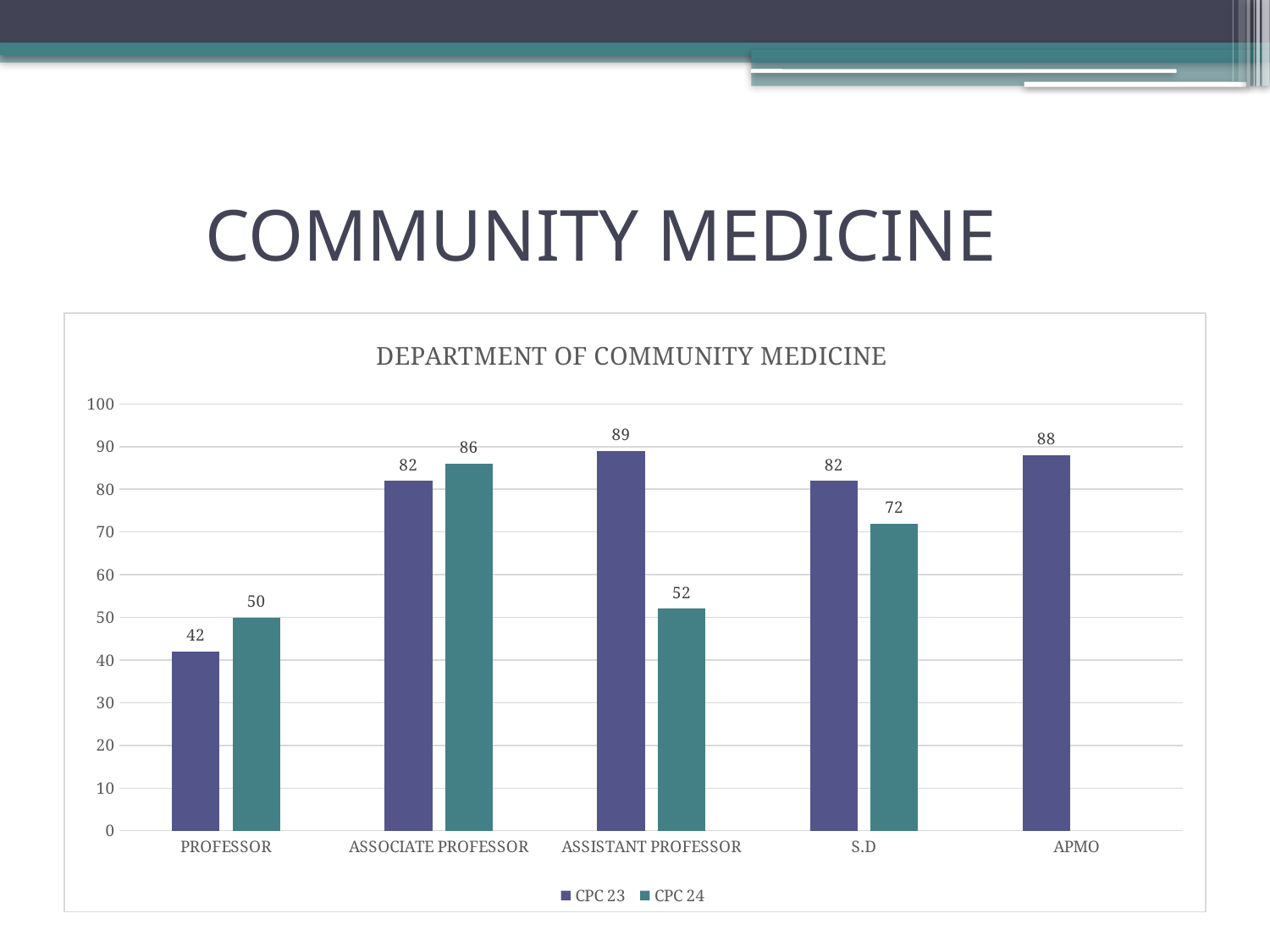
What is the difference between the CPC 23 and CPC 24 values for ASSISTANT PROFESSOR? 37 What is the title of the chart? DEPARTMENT OF COMMUNITY MEDICINE How many series does the legend list? 2 What is the CPC 24 value for ASSISTANT PROFESSOR? 52 What is the CPC 23 value for PROFESSOR? 42 What is the CPC 24 value for S.D? 72 How many categories are shown on the x axis? 5 For ASSOCIATE PROFESSOR, which series has the larger value, CPC 23 or CPC 24? CPC 24 Which category has the lowest CPC 24 value? PROFESSOR What kind of chart is shown on the slide? bar chart Which category has the highest CPC 23 value? ASSISTANT PROFESSOR Is the CPC 23 value for APMO greater or less than 80? greater